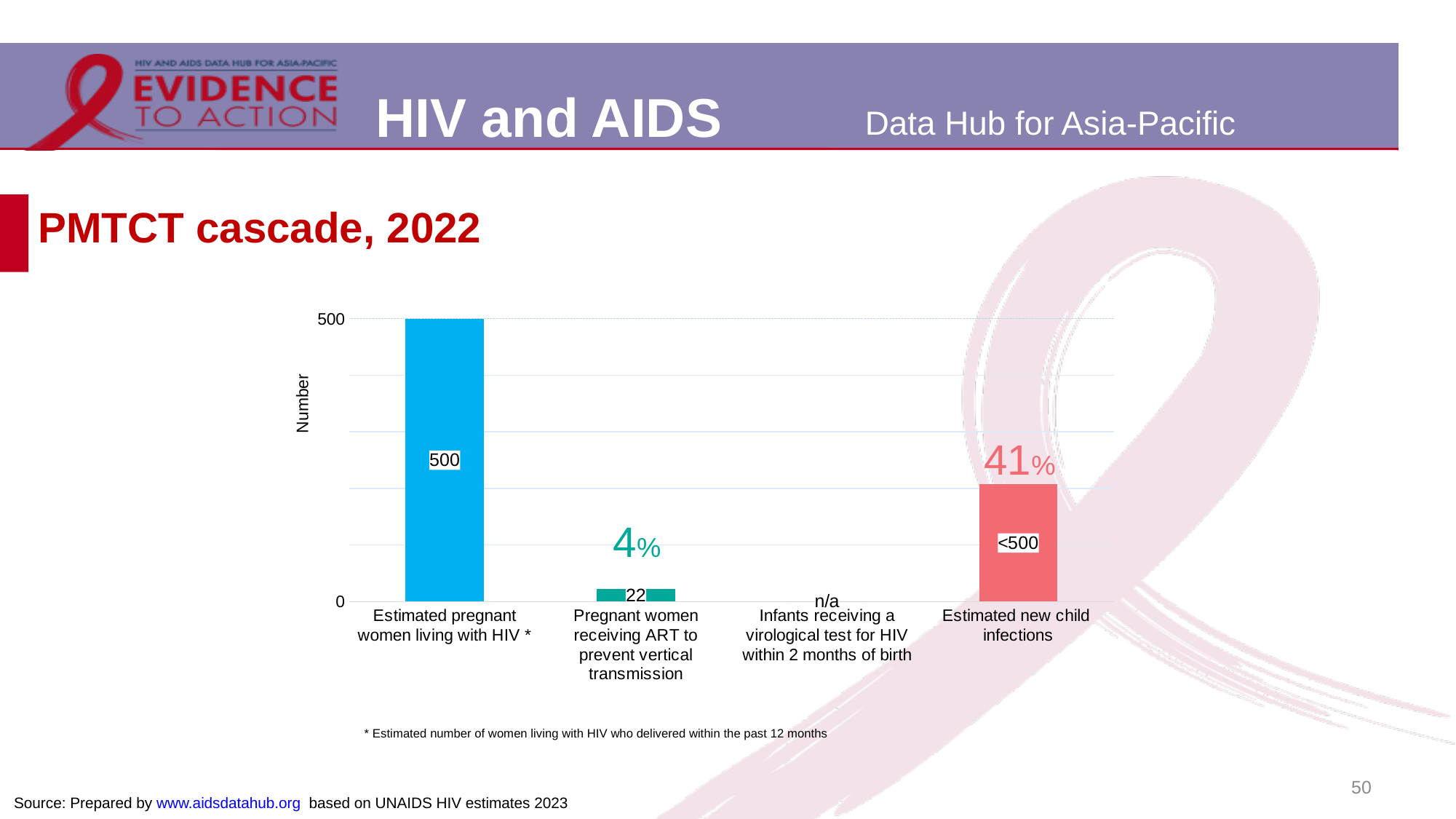
What is the value for Estimated pregnant women living with HIV? 500 Which category has the lowest plotted bar? Pregnant women receiving ART to prevent vertical transmission What percentage is shown above the bar for Pregnant women receiving ART to prevent vertical transmission? 4% Which is larger: the bar for Estimated new child infections or the bar for Pregnant women receiving ART to prevent vertical transmission? Estimated new child infections What type of chart is shown on the slide? Bar chart What percentage is shown above the bar for Estimated new child infections? 41% What value label is shown on the bar for Estimated new child infections? <500 What value is shown for Infants receiving a virological test for HIV within 2 months of birth? n/a What is the value for Pregnant women receiving ART to prevent vertical transmission? 22 Which category has the highest bar? Estimated pregnant women living with HIV What is the difference between the values for Estimated pregnant women living with HIV and Pregnant women receiving ART to prevent vertical transmission? 478 How many categories are shown on the x axis? 4